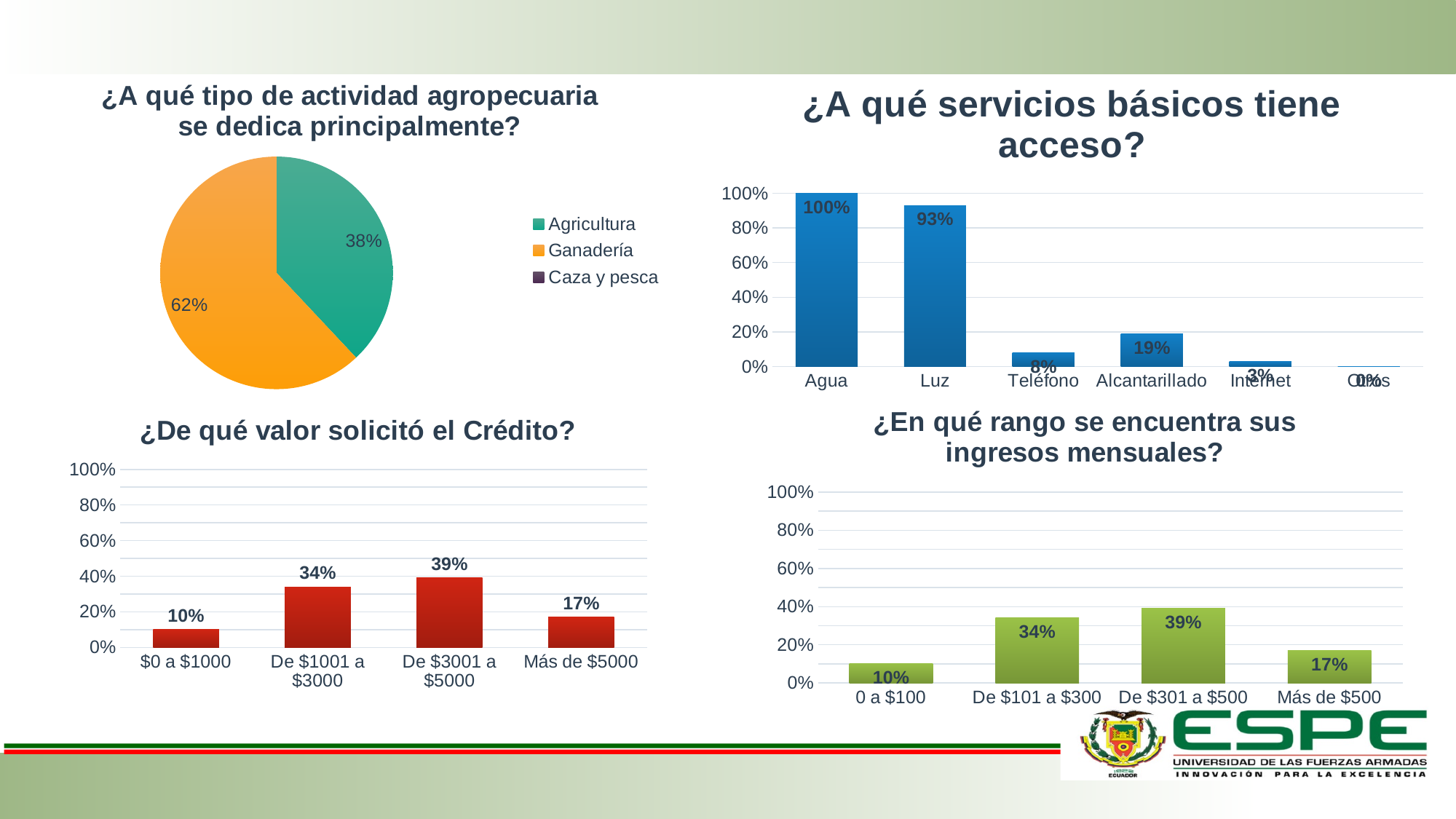
In the chart '¿A qué servicios básicos tiene acceso?', what is the value for Luz? 93% How many categories are shown in the chart '¿A qué servicios básicos tiene acceso?'? 6 In the pie chart '¿A qué tipo de actividad agropecuaria se dedica principalmente?', what share is Agricultura? 38% What kind of chart is '¿De qué valor solicitó el Crédito?'? Bar chart In the chart '¿A qué servicios básicos tiene acceso?', which service has the highest value? Agua In the chart '¿En qué rango se encuentra sus ingresos mensuales?', what is the value for 'Más de $500'? 17% In the chart '¿De qué valor solicitó el Crédito?', what is the value for 'De $3001 a $5000'? 39% In the chart '¿En qué rango se encuentra sus ingresos mensuales?', which is larger: 'De $101 a $300' or 'Más de $500'? De $101 a $300 In the chart '¿A qué servicios básicos tiene acceso?', what is the difference between Alcantarillado and Teléfono? 11% How many entries does the legend of the pie chart '¿A qué tipo de actividad agropecuaria se dedica principalmente?' list? 3 In the pie chart '¿A qué tipo de actividad agropecuaria se dedica principalmente?', what share is Ganadería? 62% In the chart '¿De qué valor solicitó el Crédito?', which category has the lowest value? $0 a $1000